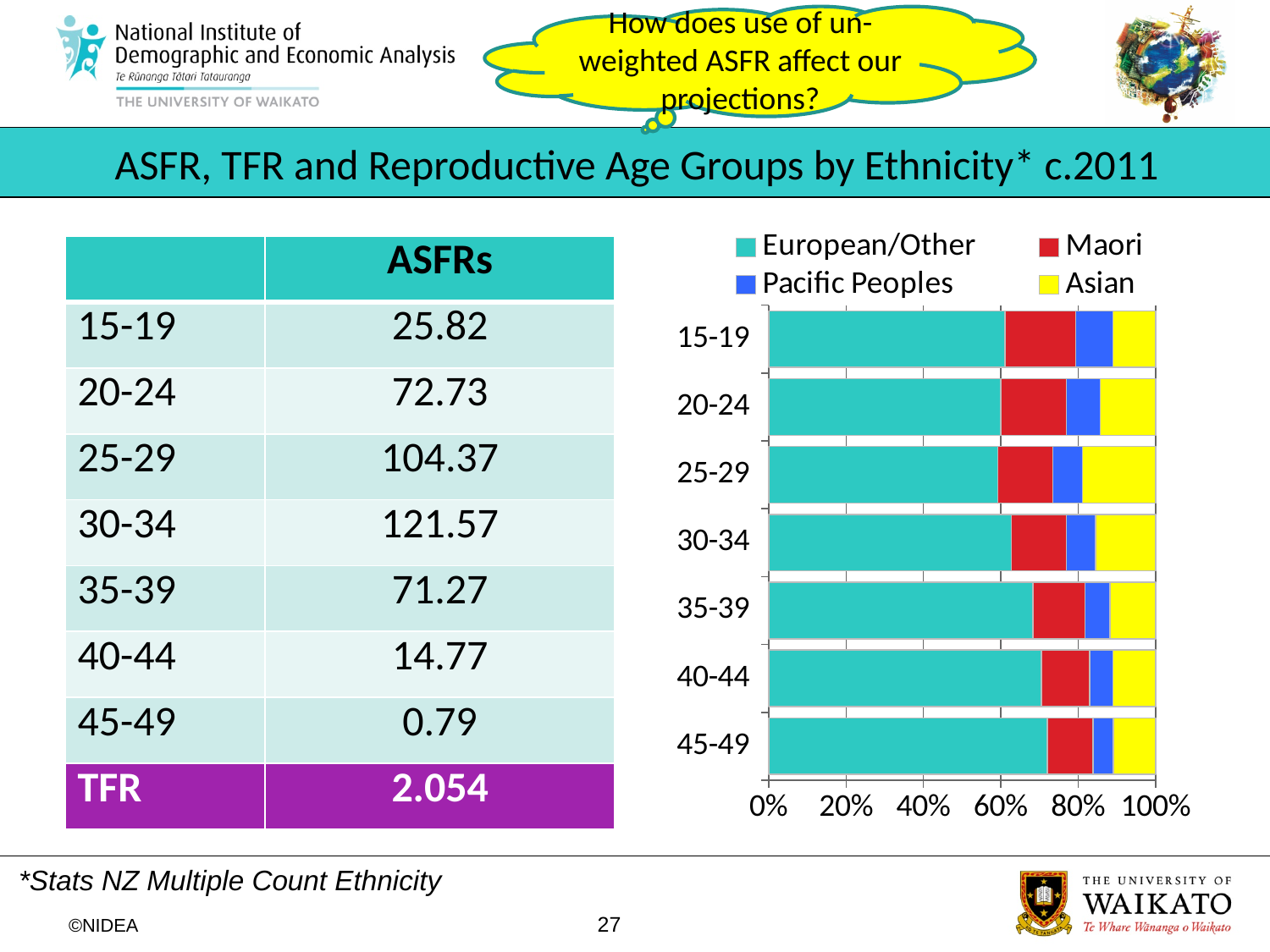
In the bar chart, is the European/Other share for the 45-49 age group greater or less than 60%? greater In the bar chart, which age group has the largest Asian share? 25-29 Which ethnic groups are listed in the bar chart's legend? European/Other, Maori, Pacific Peoples, Asian How many series does the bar chart's legend list? 4 In the bar chart, is the European/Other share for the 35-39 age group greater or less than 80%? less In the bar chart, what do the four segments of each age-group bar add up to? 100% In the bar chart, is the European/Other share for the 40-44 age group greater or less than 60%? greater In the bar chart, which age group has the largest Maori share? 15-19 In the bar chart, for the 25-29 age group, which is larger: the Asian share or the Pacific Peoples share? Asian How many age groups are plotted in the bar chart? 7 What colour represents Asian in the bar chart? yellow What kind of chart is shown on the right of the slide? stacked bar chart